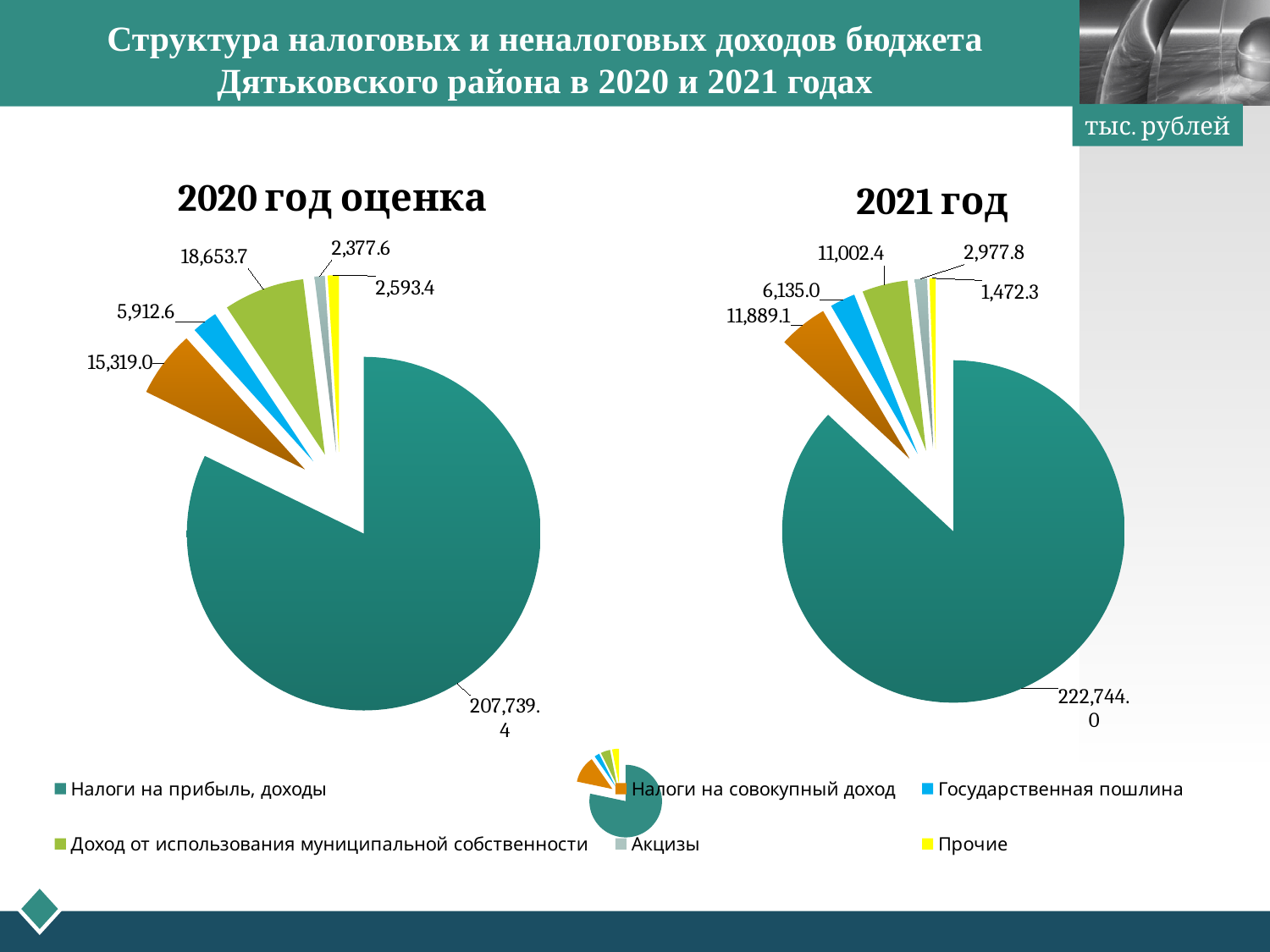
How many categories does the legend list for the pie charts? 6 By how much is the value for Налоги на прибыль, доходы in the "2021 год" chart greater than in the "2020 год оценка" chart? 15,004.6 In the "2021 год" chart, what is the value for Налоги на совокупный доход? 11,889.1 In the "2021 год" chart, what is the value for Доход от использования муниципальной собственности? 11,002.4 In the "2020 год оценка" chart, what is the value for Налоги на совокупный доход? 15,319.0 In the "2021 год" chart, what is the value for Государственная пошлина? 6,135.0 In the "2021 год" chart, which category has the largest slice? Налоги на прибыль, доходы In the "2021 год" chart, what is the value for Налоги на прибыль, доходы? 222,744.0 In the "2020 год оценка" chart, which is larger: Доход от использования муниципальной собственности or Налоги на совокупный доход? Доход от использования муниципальной собственности In the "2020 год оценка" chart, what is the value for Государственная пошлина? 5,912.6 In the "2020 год оценка" chart, what is the value for Налоги на прибыль, доходы? 207,739.4 In the "2020 год оценка" chart, what is the value for Доход от использования муниципальной собственности? 18,653.7